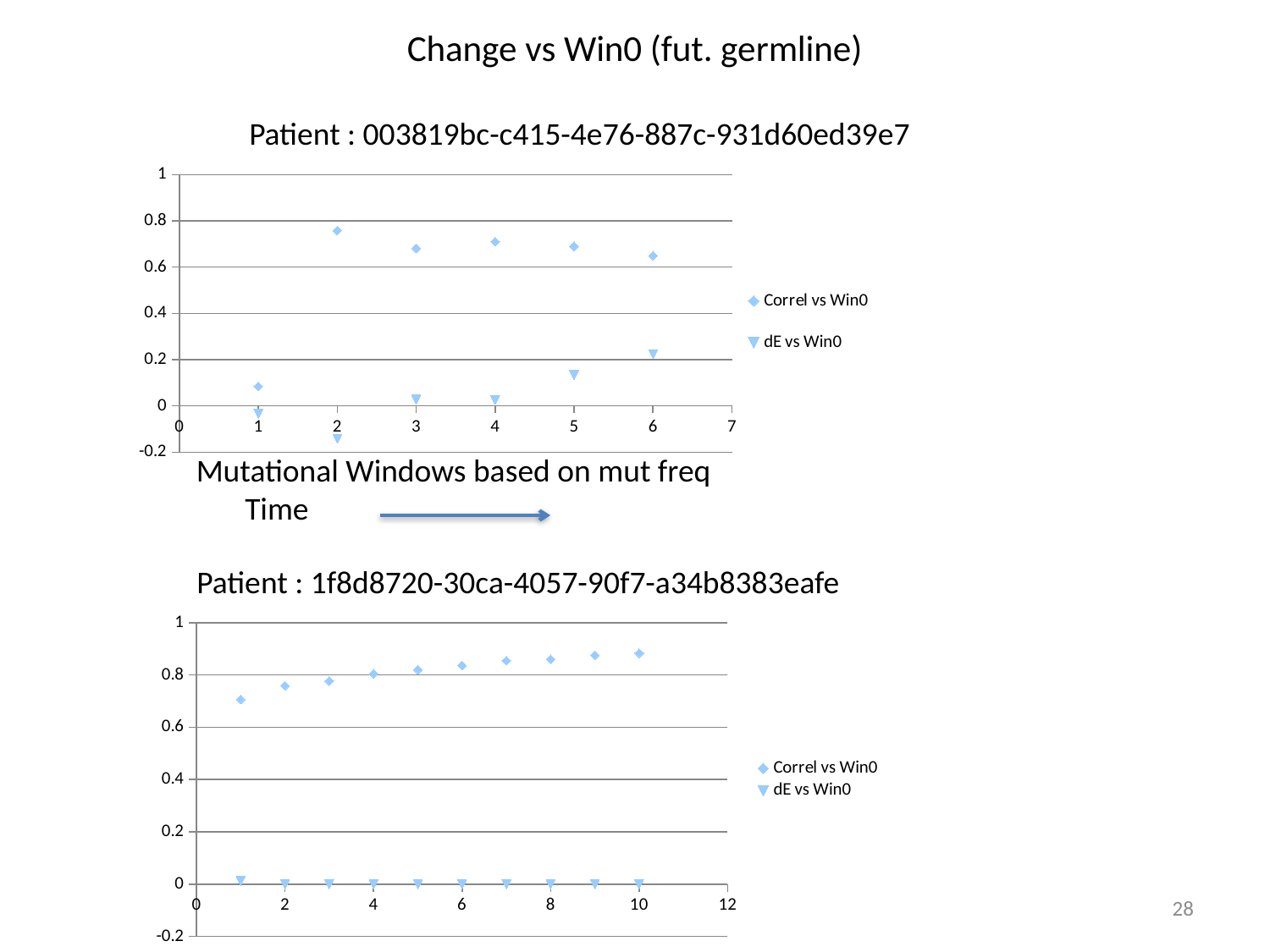
In the bottom chart (Patient 1f8d8720-30ca-4057-90f7-a34b8383eafe), does the Correl vs Win0 series rise or fall as x increases? Rise In the bottom chart (Patient 1f8d8720-30ca-4057-90f7-a34b8383eafe), how many points are plotted for the Correl vs Win0 series? 10 In the top chart (Patient 003819bc-c415-4e76-887c-931d60ed39e7), at which x value is the dE vs Win0 series lowest? 2 In the bottom chart (Patient 1f8d8720-30ca-4057-90f7-a34b8383eafe), is the Correl vs Win0 value larger at x = 1 or at x = 10? x = 10 In the top chart (Patient 003819bc-c415-4e76-887c-931d60ed39e7), at which x value is the Correl vs Win0 series highest? 2 In the bottom chart (Patient 1f8d8720-30ca-4057-90f7-a34b8383eafe), what are the two legend entries? Correl vs Win0 and dE vs Win0 In the top chart (Patient 003819bc-c415-4e76-887c-931d60ed39e7), how many series does the legend list? 2 In the top chart (Patient 003819bc-c415-4e76-887c-931d60ed39e7), how many points are plotted for the Correl vs Win0 series? 6 In the bottom chart (Patient 1f8d8720-30ca-4057-90f7-a34b8383eafe), is the Correl vs Win0 value at x = 1 greater or less than 0.8? less In the top chart (Patient 003819bc-c415-4e76-887c-931d60ed39e7), is the Correl vs Win0 value at x = 2 greater or less than 0.6? greater In the top chart (Patient 003819bc-c415-4e76-887c-931d60ed39e7), what kind of chart is shown? Scatter chart In the top chart (Patient 003819bc-c415-4e76-887c-931d60ed39e7), is the Correl vs Win0 value at x = 1 greater or less than 0.2? less